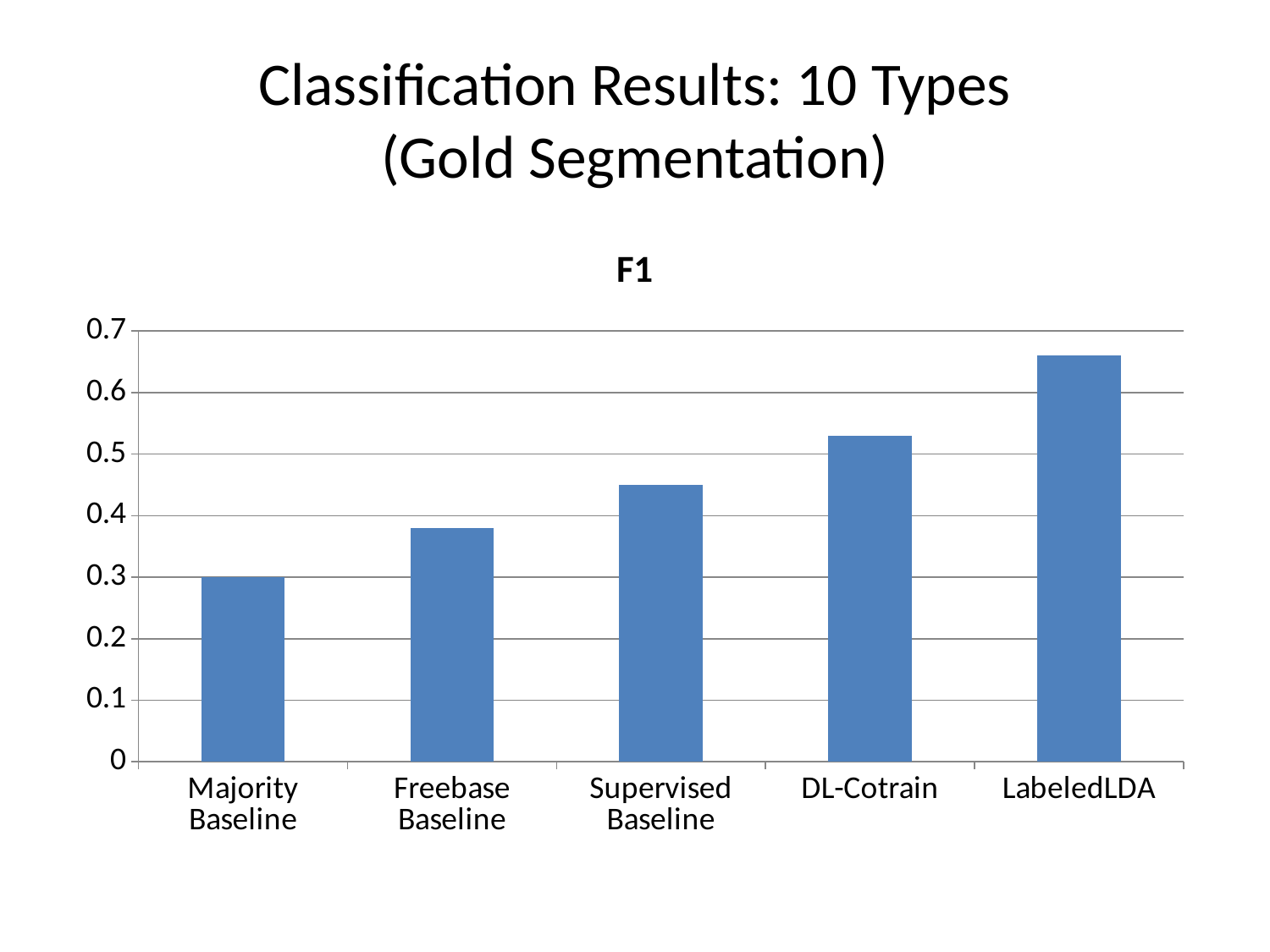
What is the title of the chart? F1 How many categories are shown on the x axis of the chart? 5 Which has a higher F1 value, DL-Cotrain or Supervised Baseline? DL-Cotrain Which category has the lowest F1 value? Majority Baseline Do the F1 values rise or fall from left to right along the x axis? rise What kind of chart is shown on the slide? bar chart Is the F1 value for Freebase Baseline greater or less than 0.4? less Is the F1 value for DL-Cotrain greater or less than 0.5? greater Which category has the highest F1 value? LabeledLDA Is the F1 value for LabeledLDA greater or less than 0.6? greater What is the F1 value for Majority Baseline? 0.3